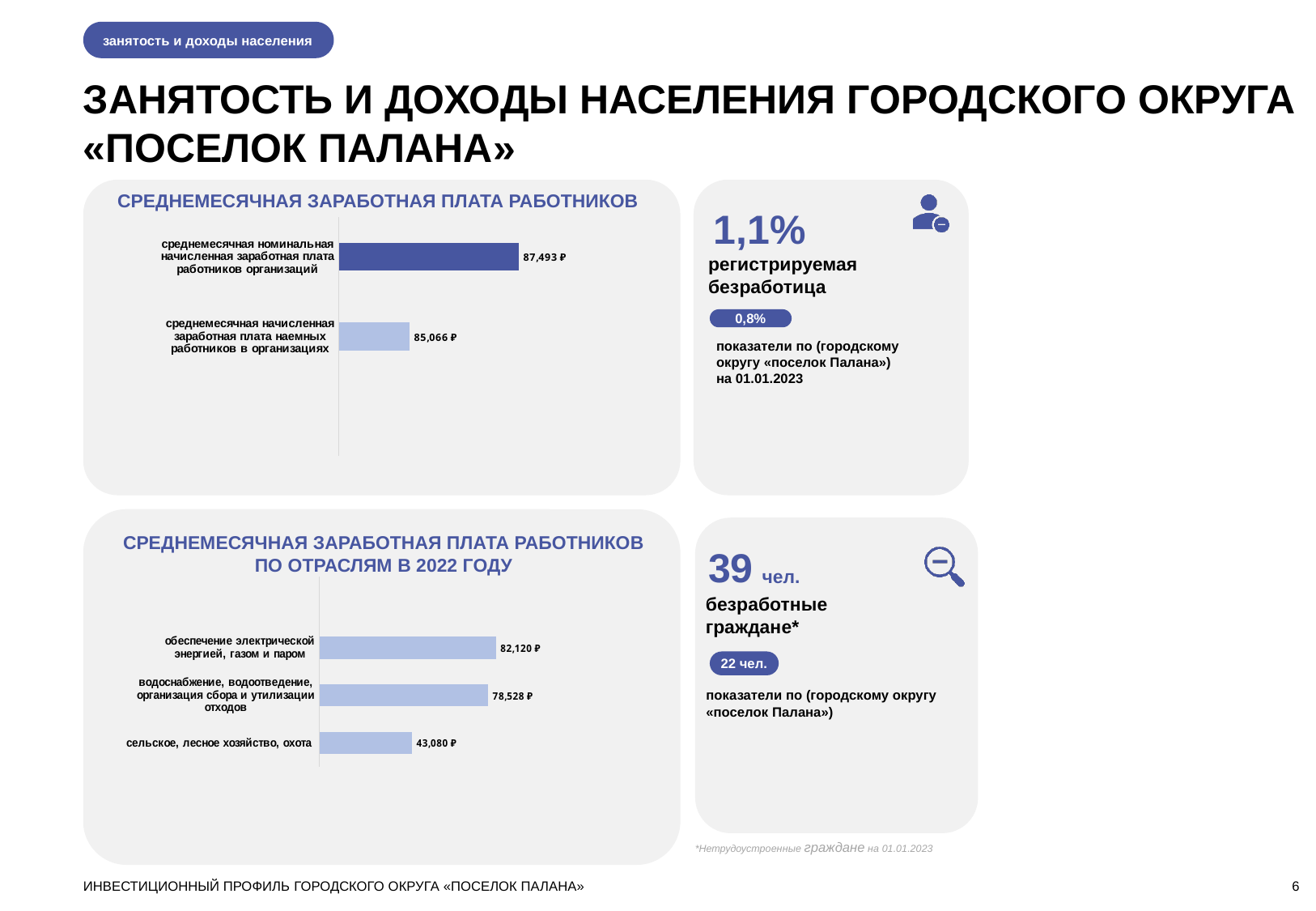
In the bottom chart 'СРЕДНЕМЕСЯЧНАЯ ЗАРАБОТНАЯ ПЛАТА РАБОТНИКОВ ПО ОТРАСЛЯМ В 2022 ГОДУ', which industry has the lowest average monthly wage? сельское, лесное хозяйство, охота In the bottom chart 'СРЕДНЕМЕСЯЧНАЯ ЗАРАБОТНАЯ ПЛАТА РАБОТНИКОВ ПО ОТРАСЛЯМ В 2022 ГОДУ', what is the value for 'обеспечение электрической энергией, газом и паром'? 82,120 ₽ In the top chart 'СРЕДНЕМЕСЯЧНАЯ ЗАРАБОТНАЯ ПЛАТА РАБОТНИКОВ', how many bars are plotted? 2 In the bottom chart 'СРЕДНЕМЕСЯЧНАЯ ЗАРАБОТНАЯ ПЛАТА РАБОТНИКОВ ПО ОТРАСЛЯМ В 2022 ГОДУ', which is larger: the value for 'водоснабжение, водоотведение, организация сбора и утилизации отходов' or for 'сельское, лесное хозяйство, охота'? водоснабжение, водоотведение, организация сбора и утилизации отходов In the bottom chart 'СРЕДНЕМЕСЯЧНАЯ ЗАРАБОТНАЯ ПЛАТА РАБОТНИКОВ ПО ОТРАСЛЯМ В 2022 ГОДУ', what is the value for 'сельское, лесное хозяйство, охота'? 43,080 ₽ In the bottom chart 'СРЕДНЕМЕСЯЧНАЯ ЗАРАБОТНАЯ ПЛАТА РАБОТНИКОВ ПО ОТРАСЛЯМ В 2022 ГОДУ', what is the difference between 'обеспечение электрической энергией, газом и паром' and 'сельское, лесное хозяйство, охота'? 39,040 ₽ In the top chart 'СРЕДНЕМЕСЯЧНАЯ ЗАРАБОТНАЯ ПЛАТА РАБОТНИКОВ', what is the value for 'среднемесячная номинальная начисленная заработная плата работников организаций'? 87,493 ₽ In the bottom chart 'СРЕДНЕМЕСЯЧНАЯ ЗАРАБОТНАЯ ПЛАТА РАБОТНИКОВ ПО ОТРАСЛЯМ В 2022 ГОДУ', how many industries are shown? 3 In the top chart 'СРЕДНЕМЕСЯЧНАЯ ЗАРАБОТНАЯ ПЛАТА РАБОТНИКОВ', what is the value for 'среднемесячная начисленная заработная плата наемных работников в организациях'? 85,066 ₽ In the top chart 'СРЕДНЕМЕСЯЧНАЯ ЗАРАБОТНАЯ ПЛАТА РАБОТНИКОВ', what is the difference between the two bars? 2,427 ₽ What kind of chart is the top chart 'СРЕДНЕМЕСЯЧНАЯ ЗАРАБОТНАЯ ПЛАТА РАБОТНИКОВ'? Bar chart In the bottom chart 'СРЕДНЕМЕСЯЧНАЯ ЗАРАБОТНАЯ ПЛАТА РАБОТНИКОВ ПО ОТРАСЛЯМ В 2022 ГОДУ', which industry has the highest average monthly wage? обеспечение электрической энергией, газом и паром